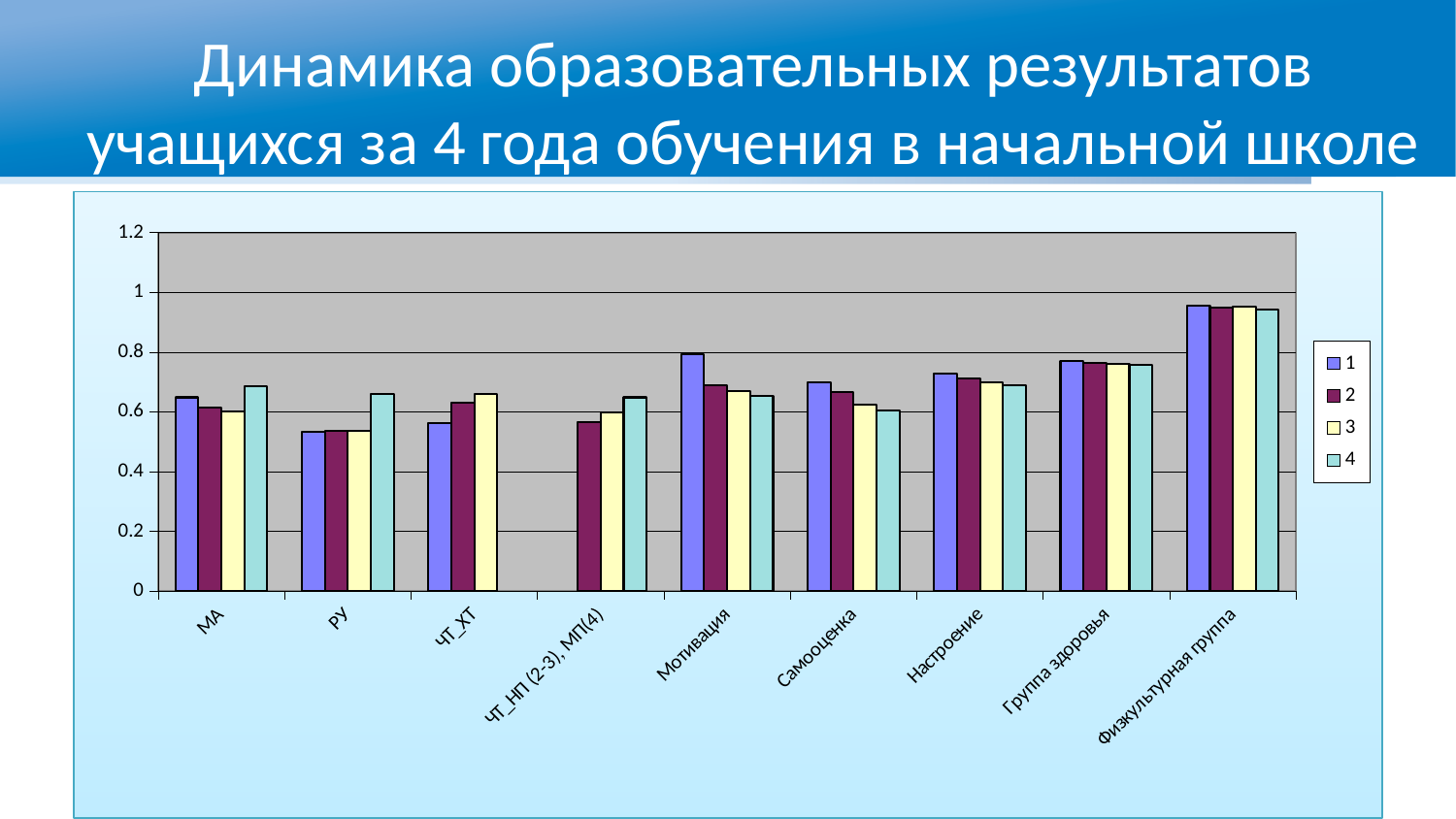
Which category has the lowest value for series 1? РУ How many series does the legend list? 4 Which category has the highest value for series 1? Физкультурная группа What is the title of the slide? Динамика образовательных результатов учащихся за 4 года обучения в начальной школе Is the value for series 1 in РУ greater or less than 0.6? less For РУ, which is larger: the value for series 4 or the value for series 1? series 4 What are the entries listed in the legend? 1, 2, 3, 4 What kind of chart is shown on the slide? bar chart How many categories are shown on the x axis? 9 Is the value for series 1 in Физкультурная группа greater or less than 0.8? greater For Мотивация, do the values rise or fall from series 1 to series 4? fall Is the value for series 4 in Самооценка greater or less than 0.8? less